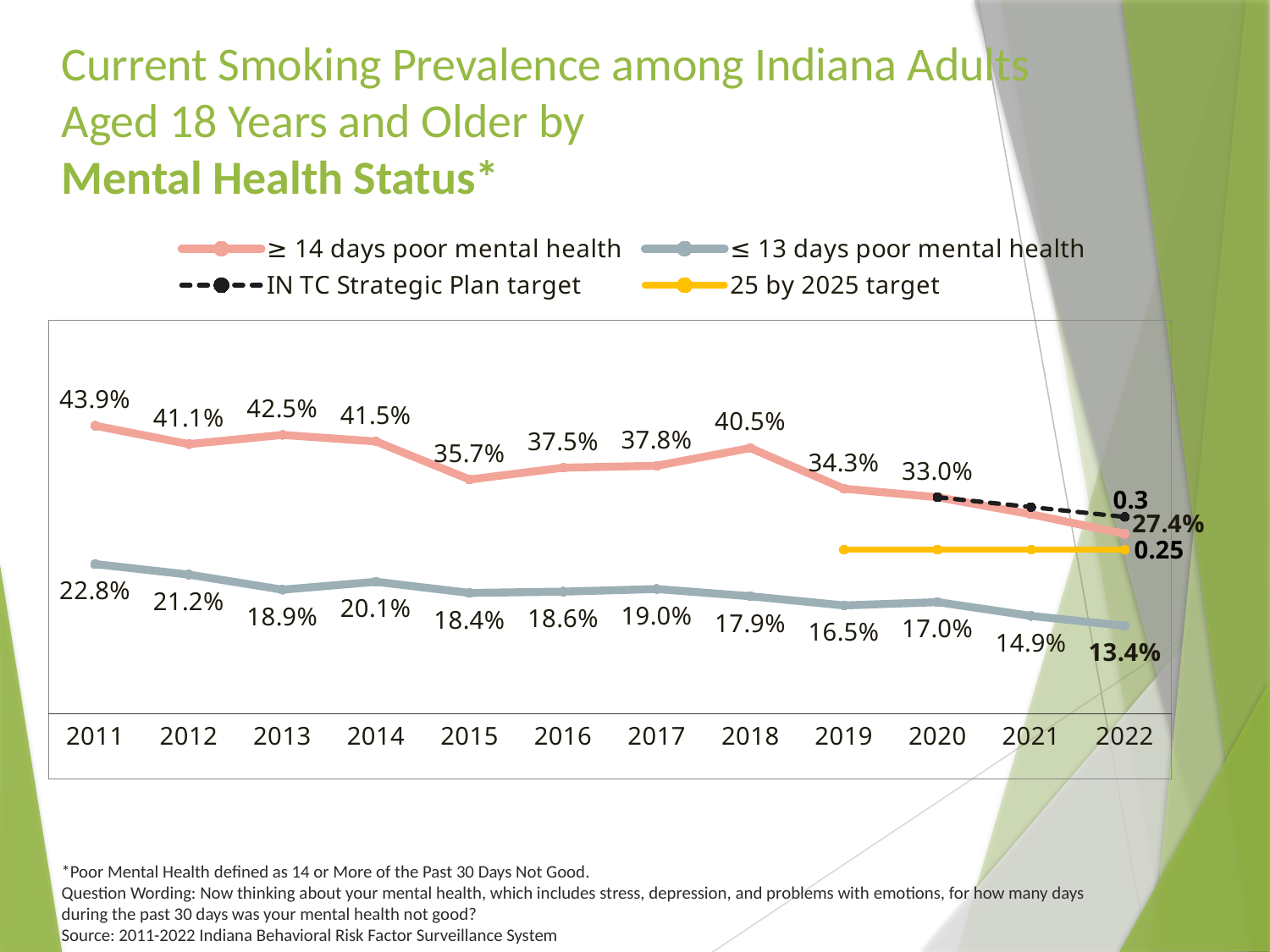
How many series does the chart legend list? 4 What is the smoking prevalence for adults with ≥ 14 days poor mental health in 2011? 43.9% Does the smoking prevalence for adults with ≤ 13 days poor mental health generally rise or fall from 2011 to 2022? Fall How many years are shown on the x axis of the chart? 12 What kind of chart is shown on the slide? Line chart What is the smoking prevalence for adults with ≤ 13 days poor mental health in 2014? 20.1% Which group had higher smoking prevalence in 2019: ≥ 14 days poor mental health or ≤ 13 days poor mental health? ≥ 14 days poor mental health What is the smoking prevalence for adults with ≤ 13 days poor mental health in 2022? 13.4% What is the smoking prevalence for adults with ≥ 14 days poor mental health in 2018? 40.5% In which year is the smoking prevalence for adults with ≤ 13 days poor mental health the lowest? 2022 In which year is the smoking prevalence for adults with ≥ 14 days poor mental health the highest? 2011 What is the difference between the ≥ 14 days and ≤ 13 days poor mental health smoking prevalence in 2022? 14.0%